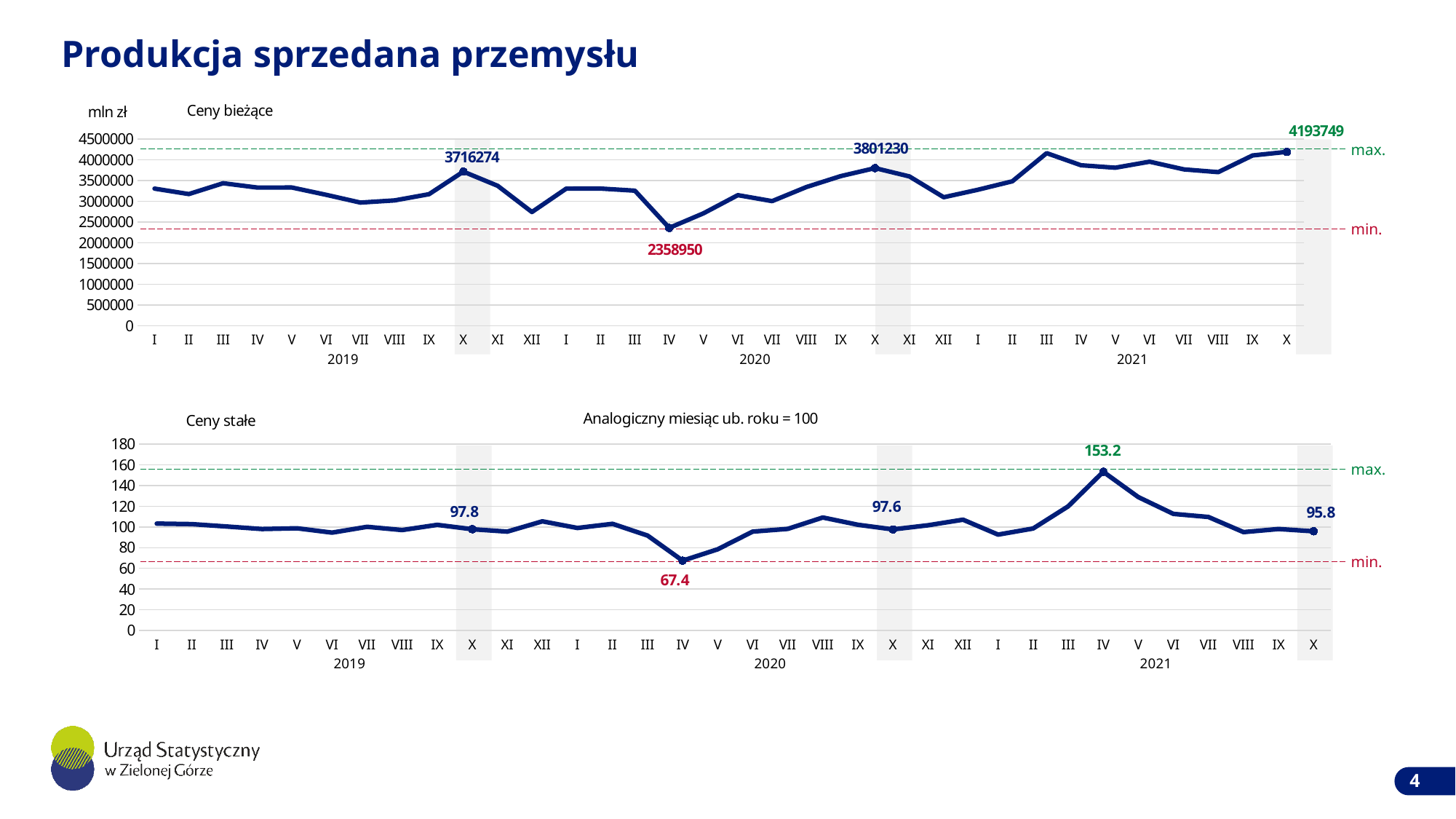
In the top chart (Ceny bieżące), which month has the lowest value? IV 2020 In the top chart (Ceny bieżące), what is the difference between the values for X 2020 and X 2019? 84956 In the bottom chart (Ceny stałe), which is larger, the value for X 2019 or the value for X 2021? X 2019 In the top chart (Ceny bieżące), is the value for XII 2019 greater or less than 3000000? less In the top chart (Ceny bieżące), what is the value for IV 2020? 2358950 In the top chart (Ceny bieżące), what is the value for X 2021? 4193749 In the bottom chart (Ceny stałe), which month has the highest value? IV 2021 In the top chart (Ceny bieżące), what is the value for X 2020? 3801230 What type of chart is the top chart (Ceny bieżące)? Line chart In the bottom chart (Ceny stałe), what is the difference between the values for X 2019 and X 2020? 0.2 In the bottom chart (Ceny stałe), what is the value for IV 2021? 153.2 In the bottom chart (Ceny stałe), what is the value for X 2021? 95.8